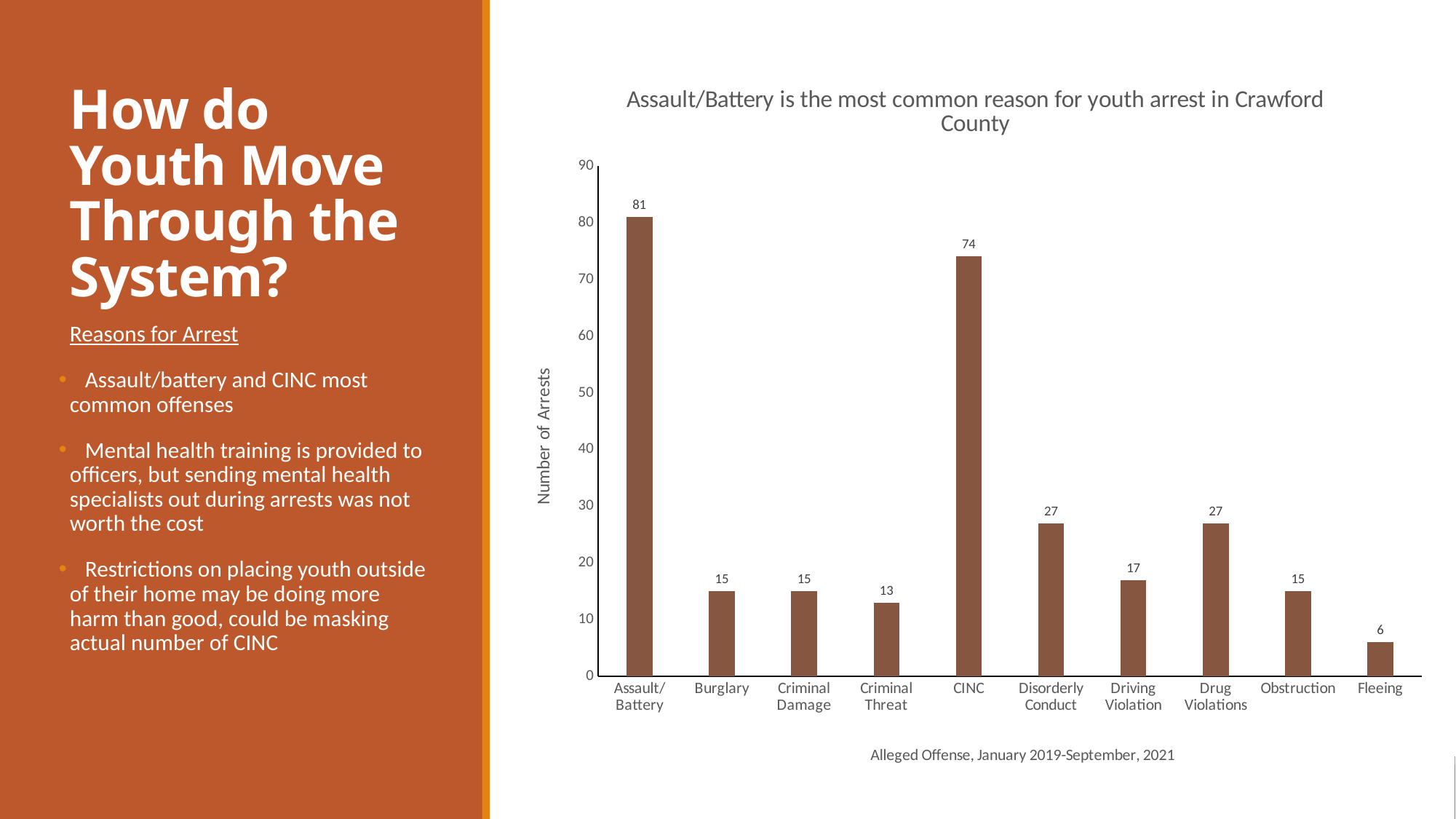
What is the number of arrests for Fleeing? 6 What is the label of the vertical axis? Number of Arrests Which alleged offense has the highest number of arrests? Assault/Battery What is the number of arrests for Driving Violation? 17 Which has more arrests, Disorderly Conduct or Criminal Threat? Disorderly Conduct What is the number of arrests for Assault/Battery? 81 What is the number of arrests for CINC? 74 What is the difference in number of arrests between Assault/Battery and CINC? 7 What kind of chart is shown on the slide? Bar chart Which alleged offense has the lowest number of arrests? Fleeing Is the value for Drug Violations greater or less than 20? greater How many alleged offense categories are shown on the x axis? 10